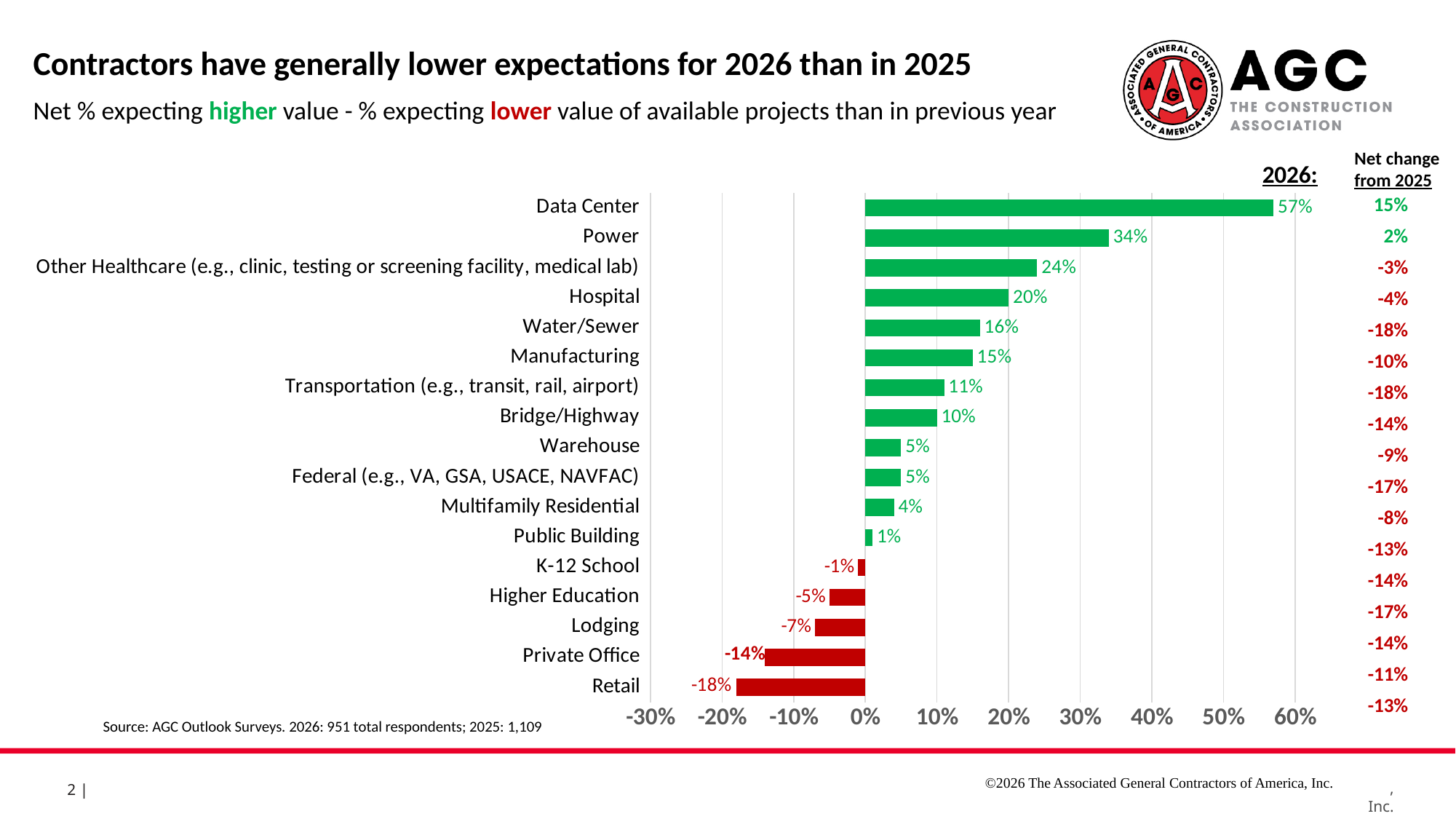
What kind of chart is shown on the slide? Bar chart What colour are the bars for categories with negative 2026 net percentages? Red Which category has the lowest 2026 net percentage? Retail What is the 2026 net percentage for Data Center? 57% Which category has the highest 2026 net percentage? Data Center What is the net change from 2025 shown for Data Center? 15% How many categories are shown in the chart? 17 What is the net change from 2025 shown for Water/Sewer? -18% What is the 2026 net percentage for Water/Sewer? 16% What is the difference between the 2026 net percentages for Data Center and Power? 23% What is the 2026 net percentage for Retail? -18% Which has a higher 2026 net percentage, Hospital or Manufacturing? Hospital